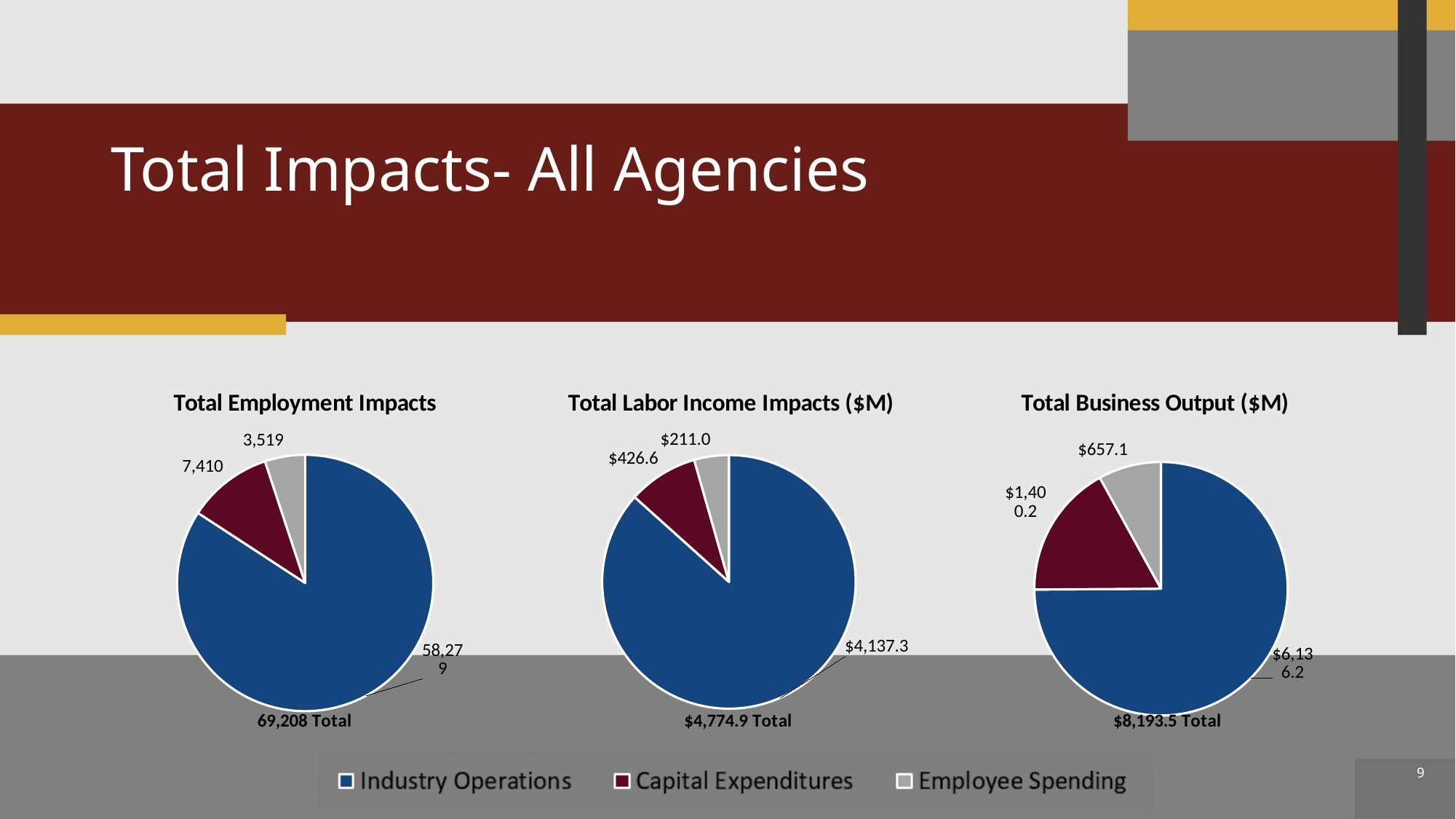
In the Total Employment Impacts chart, what is the value for Capital Expenditures? 7,410 In the Total Labor Income Impacts ($M) chart, is the value for Capital Expenditures larger or smaller than the value for Employee Spending? larger What total is shown below the Total Business Output ($M) chart? $8,193.5 Total In the Total Labor Income Impacts ($M) chart, what is the value for Industry Operations? $4,137.3 In the Total Business Output ($M) chart, what is the value for Employee Spending? $657.1 In the Total Employment Impacts chart, what is the value for Employee Spending? 3,519 In the Total Labor Income Impacts ($M) chart, which category has the smallest slice? Employee Spending In the Total Business Output ($M) chart, which category has the largest slice? Industry Operations In the Total Employment Impacts chart, what is the difference between Capital Expenditures and Employee Spending? 3,891 How many series does the legend list? 3 What type of chart is used for Total Employment Impacts? Pie chart In the Total Labor Income Impacts ($M) chart, what is the value for Capital Expenditures? $426.6